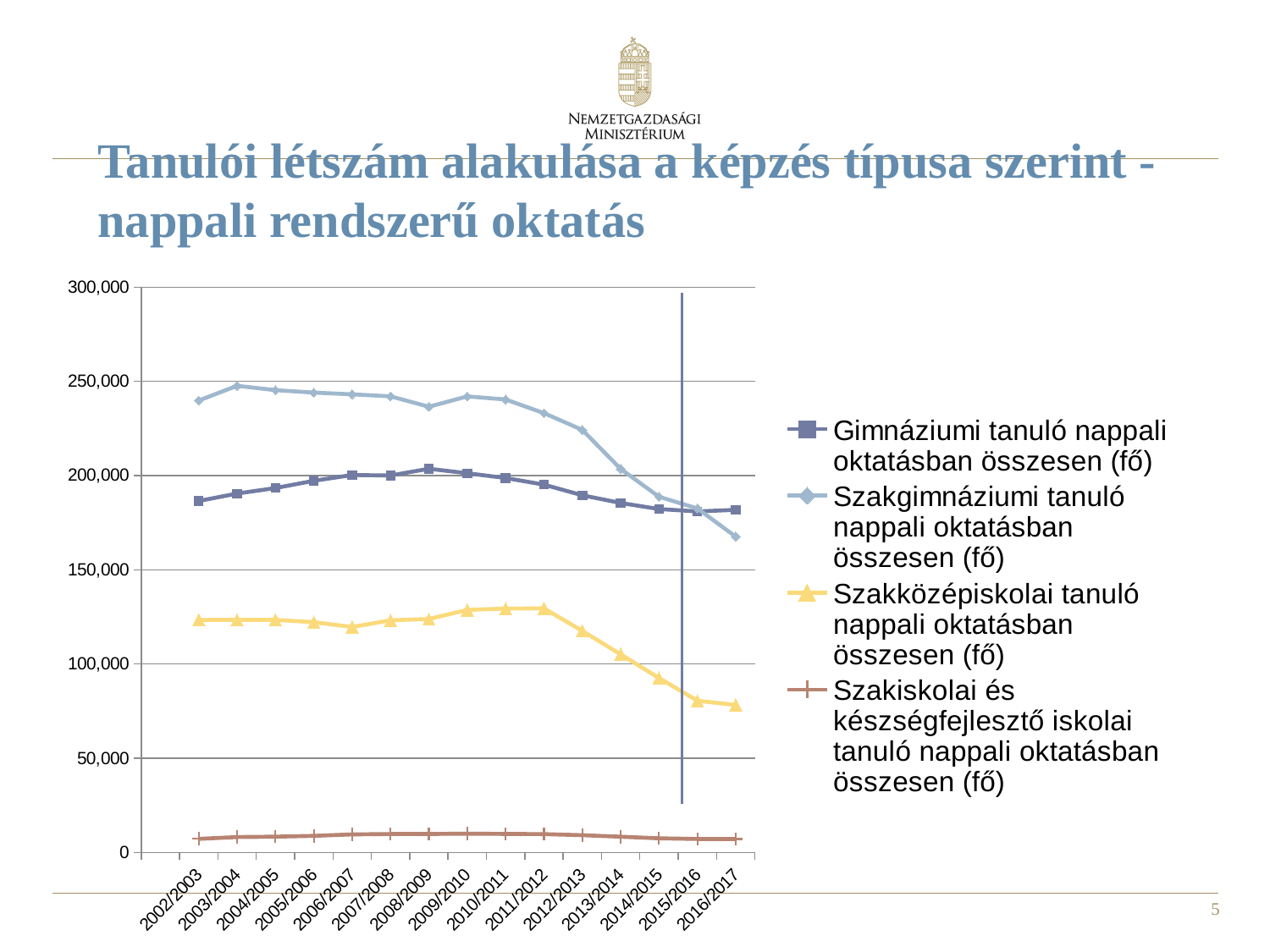
What kind of chart is shown on the slide? line chart Is the value for Szakközépiskolai tanuló in 2016/2017 greater or less than 100,000? less Is the value for Szakgimnáziumi tanuló in 2002/2003 greater or less than 200,000? greater In 2016/2017, which is larger: Gimnáziumi tanuló or Szakgimnáziumi tanuló? Gimnáziumi tanuló How many school years are shown on the x axis? 15 Is the value for Gimnáziumi tanuló in 2002/2003 greater or less than 200,000? less Does the Szakgimnáziumi tanuló series rise or fall from 2012/2013 to 2016/2017? fall How many series does the legend list? 4 Does the Szakközépiskolai tanuló series rise or fall from 2011/2012 to 2016/2017? fall What is the title of the slide containing the chart? Tanulói létszám alakulása a képzés típusa szerint - nappali rendszerű oktatás Which series has the highest value in 2002/2003? Szakgimnáziumi tanuló nappali oktatásban összesen (fő) Which series has the lowest value in 2016/2017? Szakiskolai és készségfejlesztő iskolai tanuló nappali oktatásban összesen (fő)